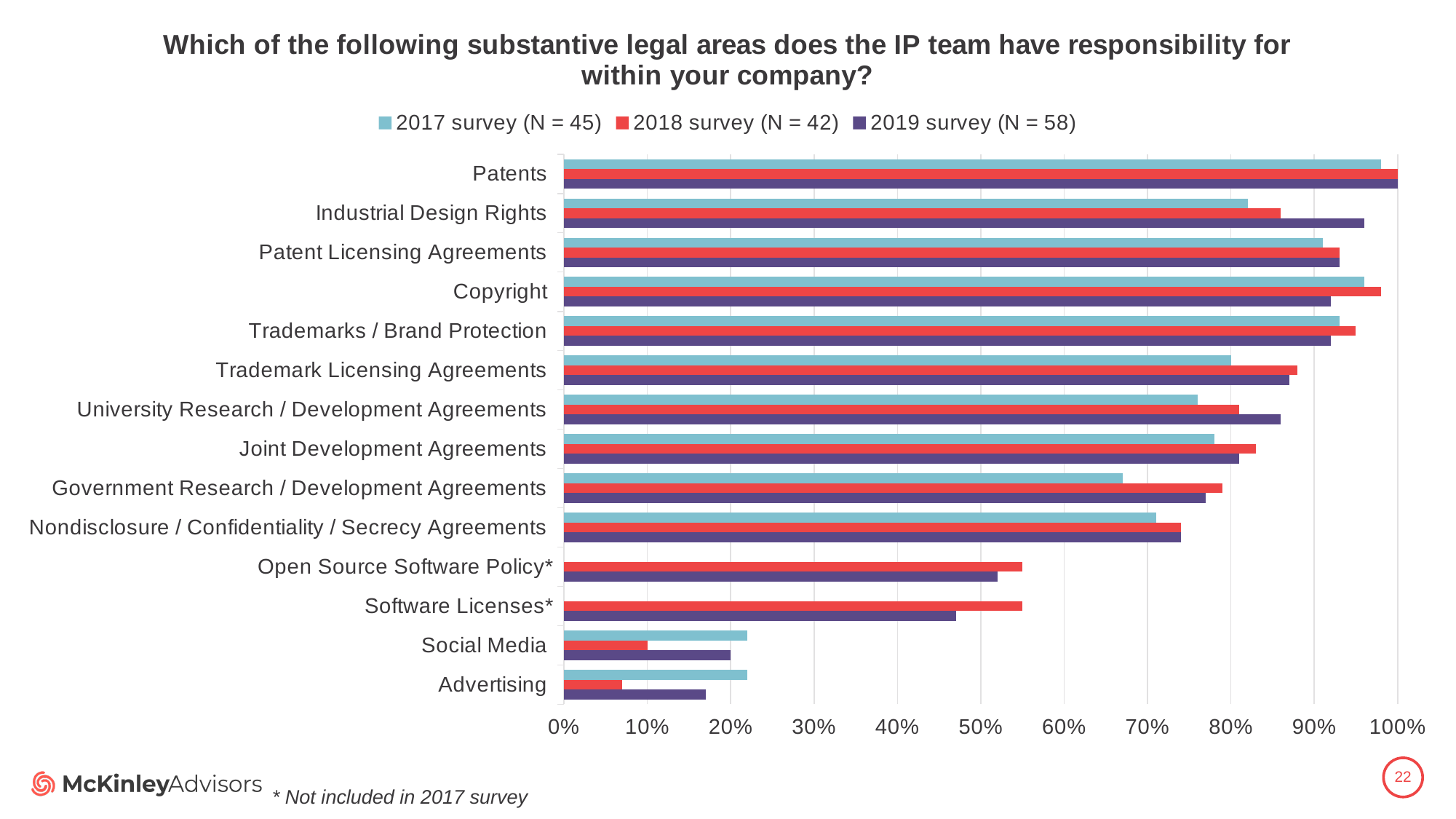
Which legal area has the lowest value in the 2018 survey? Advertising Which is larger for Social Media: the 2017 survey value or the 2018 survey value? 2017 survey According to the legend, how many respondents (N) were in the 2019 survey? 58 Which is larger for Industrial Design Rights: the 2017 survey value or the 2019 survey value? 2019 survey What is the value for Patents in the 2019 survey? 100% How many survey series does the legend list? 3 What kind of chart is shown on the slide? bar chart Is the value for Government Research / Development Agreements in the 2017 survey greater or less than 70%? less Is the value for Open Source Software Policy in the 2018 survey greater or less than 50%? greater How many legal areas (categories) are listed on the chart? 14 Is the value for Advertising in the 2018 survey greater or less than 10%? less